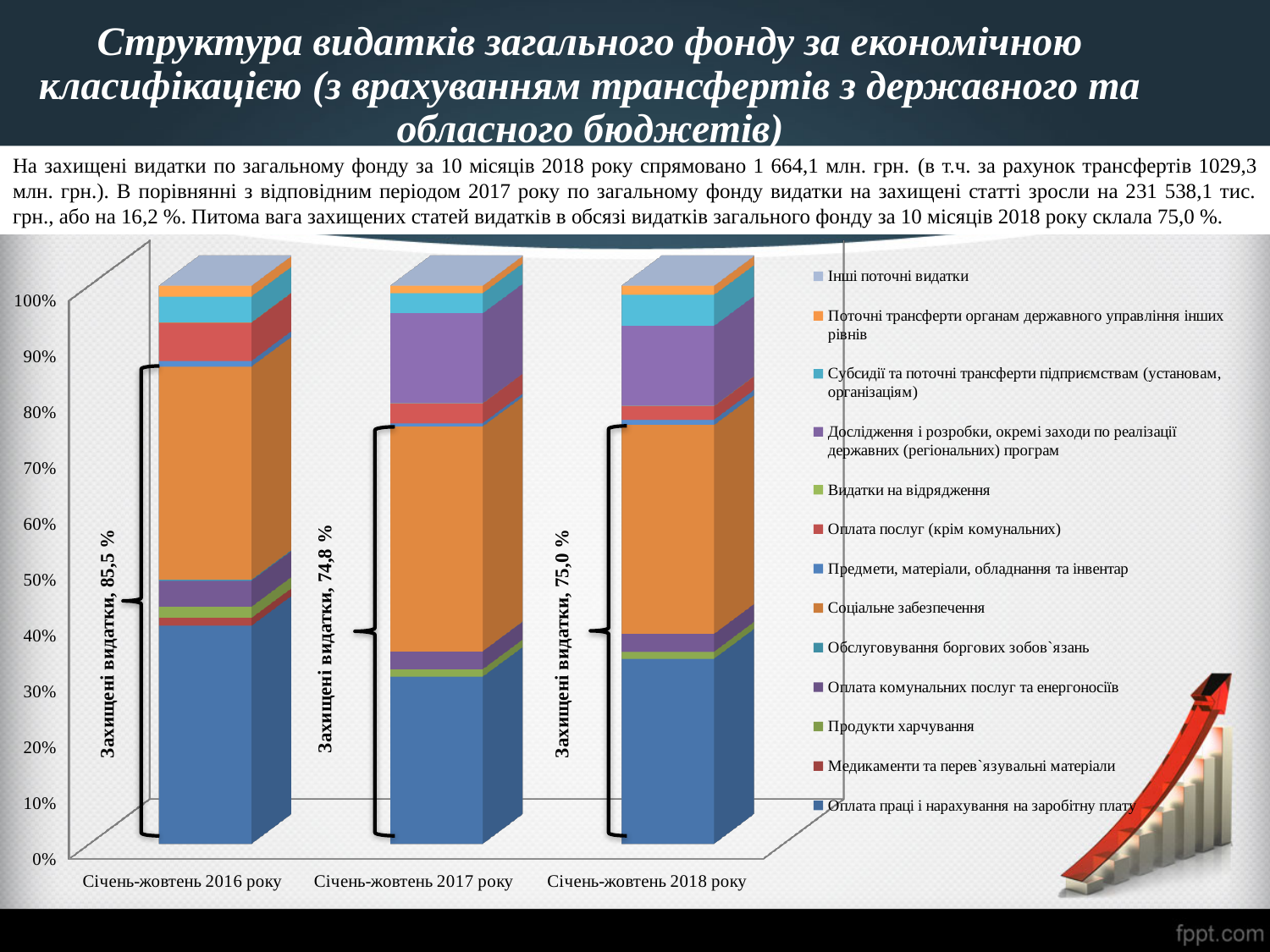
Which is larger: the protected expenditures share for Січень-жовтень 2018 року or for Січень-жовтень 2017 року? Січень-жовтень 2018 року How many series does the chart legend list? 13 Which series is listed last in the chart legend? Оплата праці і нарахування на заробітну плату Which period has the highest annotated share of protected expenditures? Січень-жовтень 2016 року What share of protected expenditures (Захищені видатки) is annotated for Січень-жовтень 2018 року? 75,0 % Is the share of Оплата праці і нарахування на заробітну плату in Січень-жовтень 2017 року greater or less than 40%? less How many periods (categories) are shown on the x axis of the chart? 3 What share of protected expenditures (Захищені видатки) is annotated for Січень-жовтень 2016 року? 85,5 % By how many percentage points does the protected expenditures share for 2016 exceed that for 2017? 10,7 What kind of chart is shown on the slide? Stacked bar chart Which period has the lowest annotated share of protected expenditures? Січень-жовтень 2017 року What share of protected expenditures (Захищені видатки) is annotated for Січень-жовтень 2017 року? 74,8 %